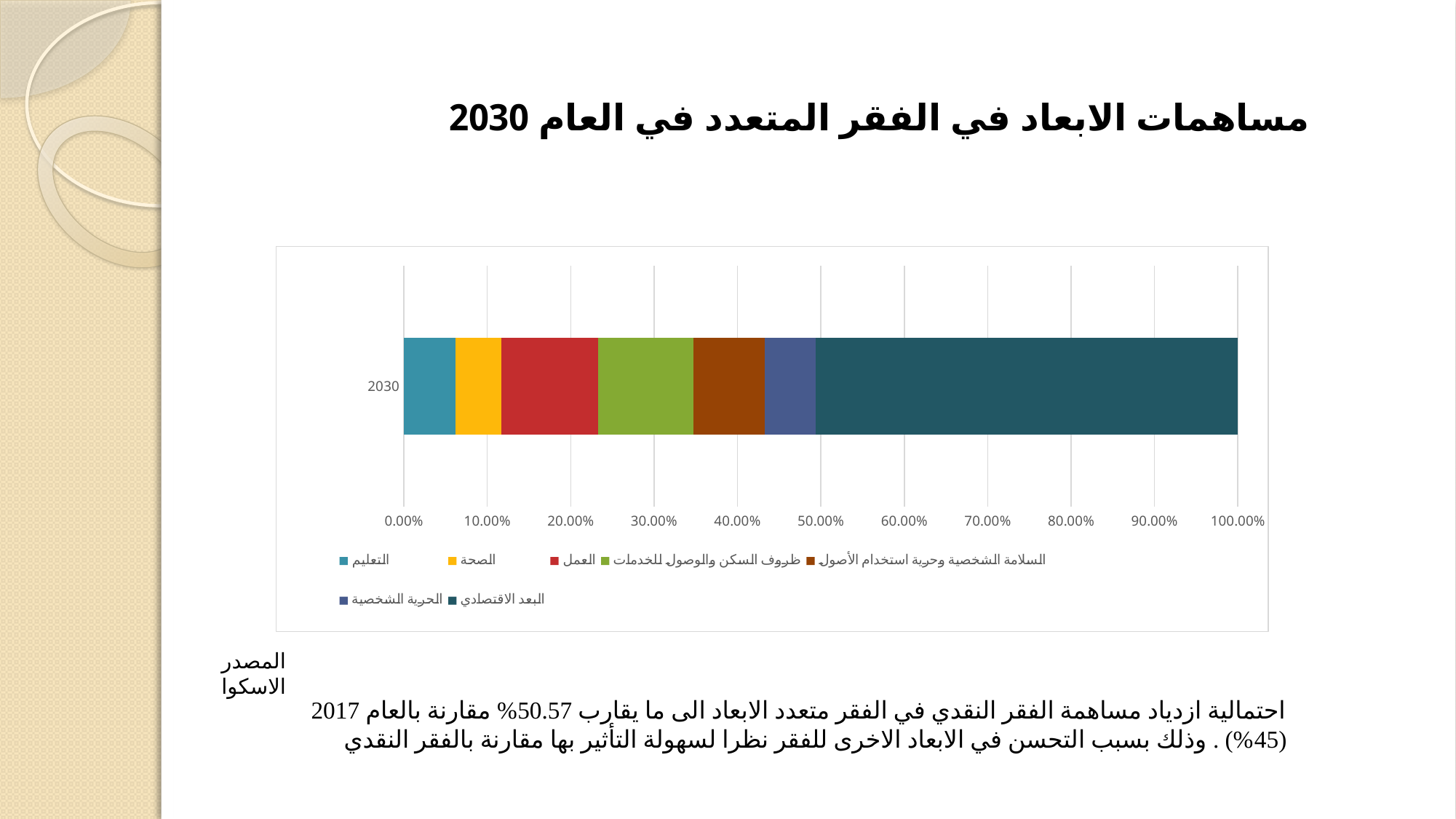
Is the value for البعد الاقتصادي in 2030 greater or less than 40.00%? greater Is the value for العمل in 2030 greater or less than 20.00%? less Which is larger in 2030, the value for البعد الاقتصادي or the value for الحرية الشخصية? البعد الاقتصادي Which is larger in 2030, the value for ظروف السكن والوصول للخدمات or the value for الصحة? ظروف السكن والوصول للخدمات What kind of chart is shown on the slide? stacked bar chart How many series does the chart legend list? 7 Is the value for التعليم in 2030 greater or less than 10.00%? less Which series takes up the largest share of the stacked bar for 2030? البعد الاقتصادي What is the title of the chart on the slide? مساهمات الابعاد في الفقر المتعدد في العام 2030 How many categories are plotted on the vertical axis of the chart? 1 What is the total of the stacked bar for 2030, as read from the horizontal axis? 100.00% What is the category label shown on the vertical axis of the chart? 2030